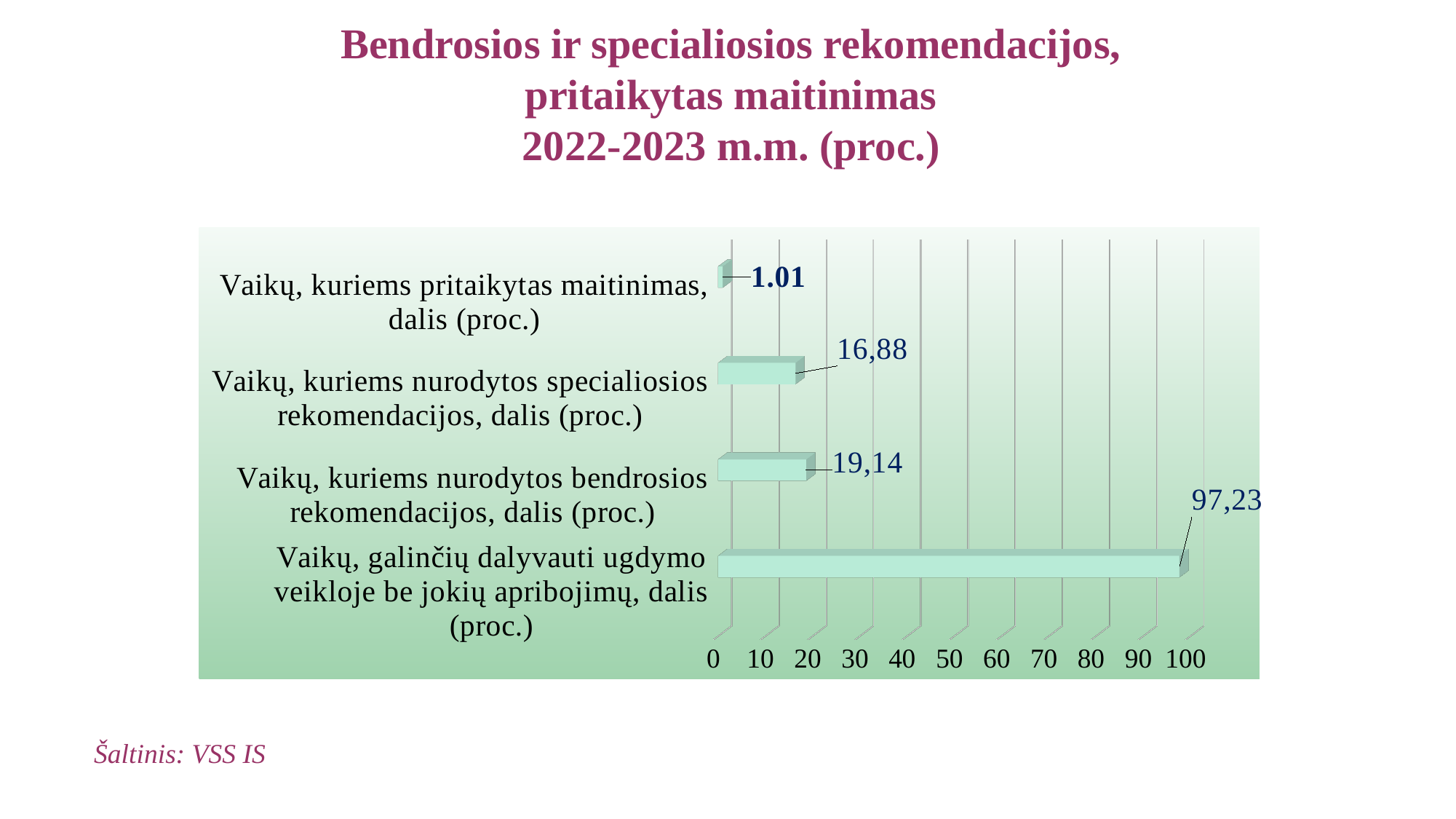
What is the source cited at the bottom of the slide? VSS IS What is the value for "Vaikų, kuriems nurodytos specialiosios rekomendacijos, dalis (proc.)"? 16,88 What is the value for "Vaikų, galinčių dalyvauti ugdymo veikloje be jokių apribojimų, dalis (proc.)"? 97,23 Which category has the highest value? Vaikų, galinčių dalyvauti ugdymo veikloje be jokių apribojimų, dalis (proc.) What is the value for "Vaikų, kuriems nurodytos bendrosios rekomendacijos, dalis (proc.)"? 19,14 What kind of chart is shown on the slide? Bar chart How many categories are shown in the chart? 4 Which category has the lowest value? Vaikų, kuriems pritaikytas maitinimas, dalis (proc.) Is the value for "Vaikų, galinčių dalyvauti ugdymo veikloje be jokių apribojimų, dalis (proc.)" greater or less than 90? greater What is the difference between the values for bendrosios rekomendacijos (19,14) and specialiosios rekomendacijos (16,88)? 2,26 What is the value for "Vaikų, kuriems pritaikytas maitinimas, dalis (proc.)"? 1.01 Which is larger: the value for bendrosios rekomendacijos or the value for specialiosios rekomendacijos? Bendrosios rekomendacijos